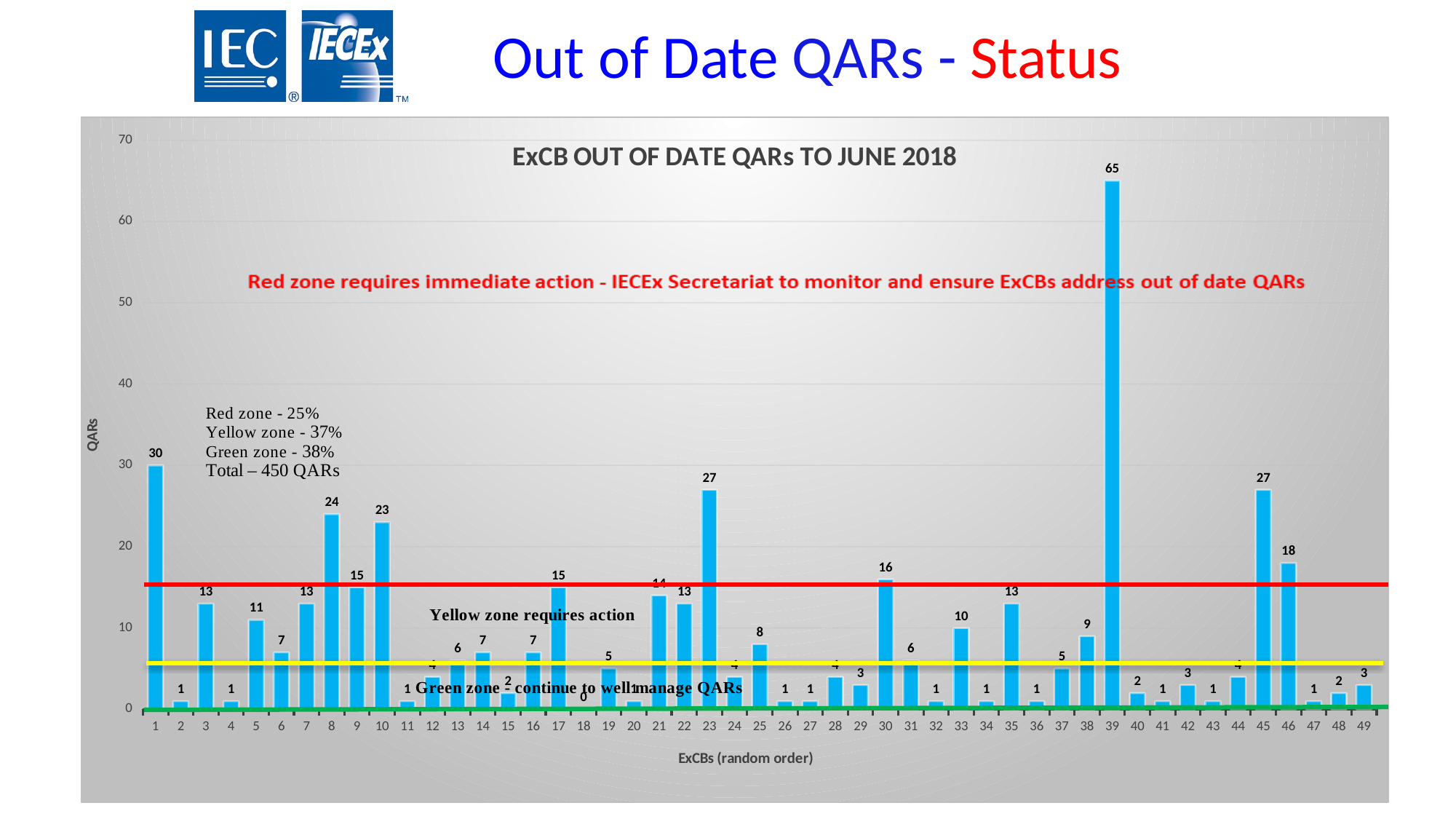
How many out of date QARs does ExCB 1 have? 30 How many out of date QARs does ExCB 23 have? 27 How many ExCBs are shown on the x axis of the chart? 49 What kind of chart is shown on the slide? bar chart What is the difference between the values for ExCB 39 and ExCB 45? 38 What is the label of the x axis? ExCBs (random order) Which ExCB has the highest number of out of date QARs? 39 Which has more out of date QARs, ExCB 30 or ExCB 46? ExCB 46 How many out of date QARs does ExCB 33 have? 10 How many out of date QARs does ExCB 46 have? 18 How many out of date QARs does ExCB 39 have? 65 What is the title of the chart? ExCB OUT OF DATE QARs TO JUNE 2018